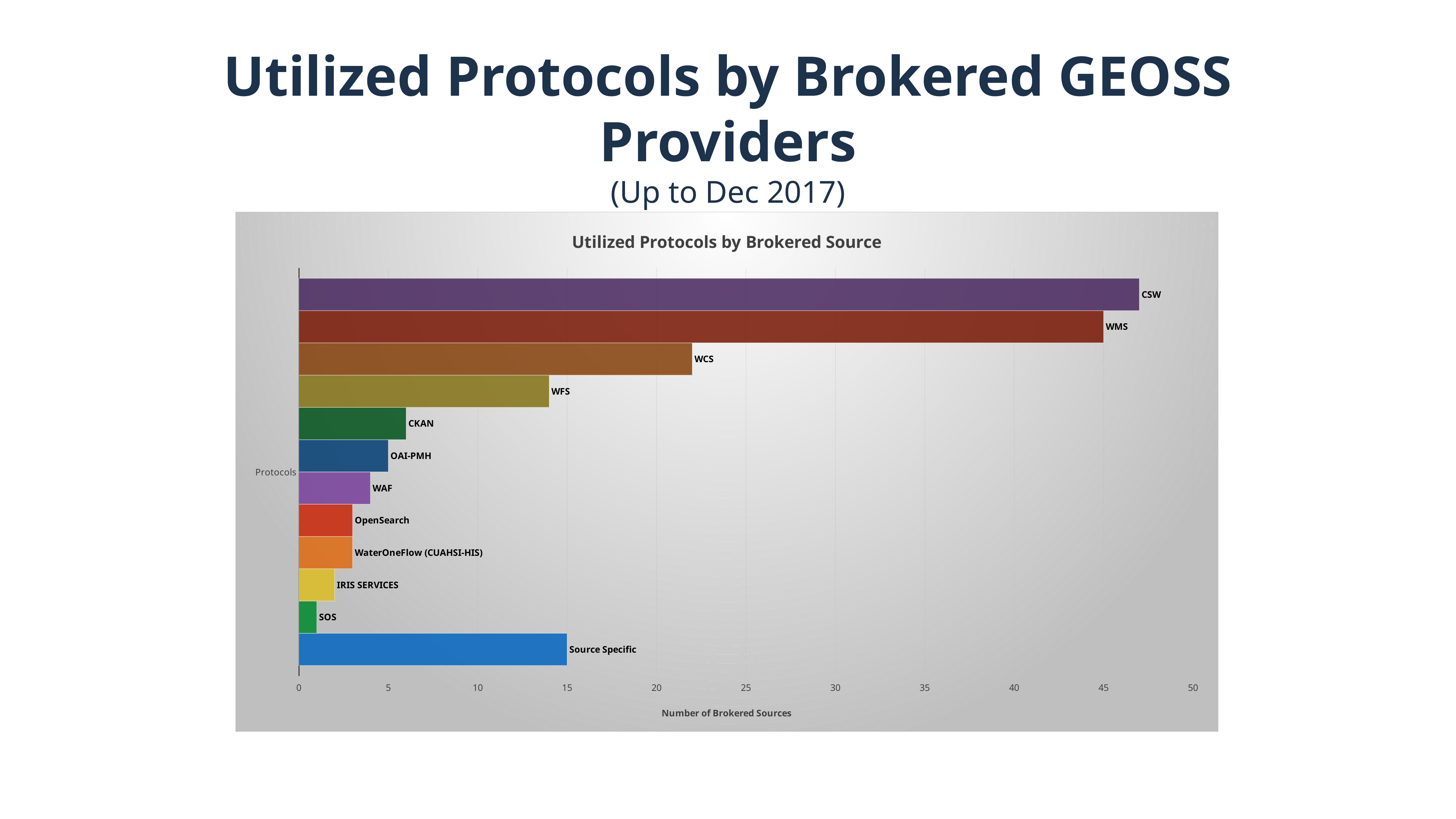
Which protocol has the highest number of brokered sources? CSW Is the value for WAF greater or less than 5? less What kind of chart is shown on the slide? bar chart What is the number of brokered sources for Source Specific? 15 Which has more brokered sources, WCS or WFS? WCS How many protocols (bars) are shown in the chart? 12 Is the value for WCS greater or less than 20? greater Is the value for CSW greater or less than 45? greater Which protocol has the lowest number of brokered sources? SOS What is the label of the horizontal axis of the chart? Number of Brokered Sources What is the number of brokered sources for WMS? 45 What is the number of brokered sources for OAI-PMH? 5